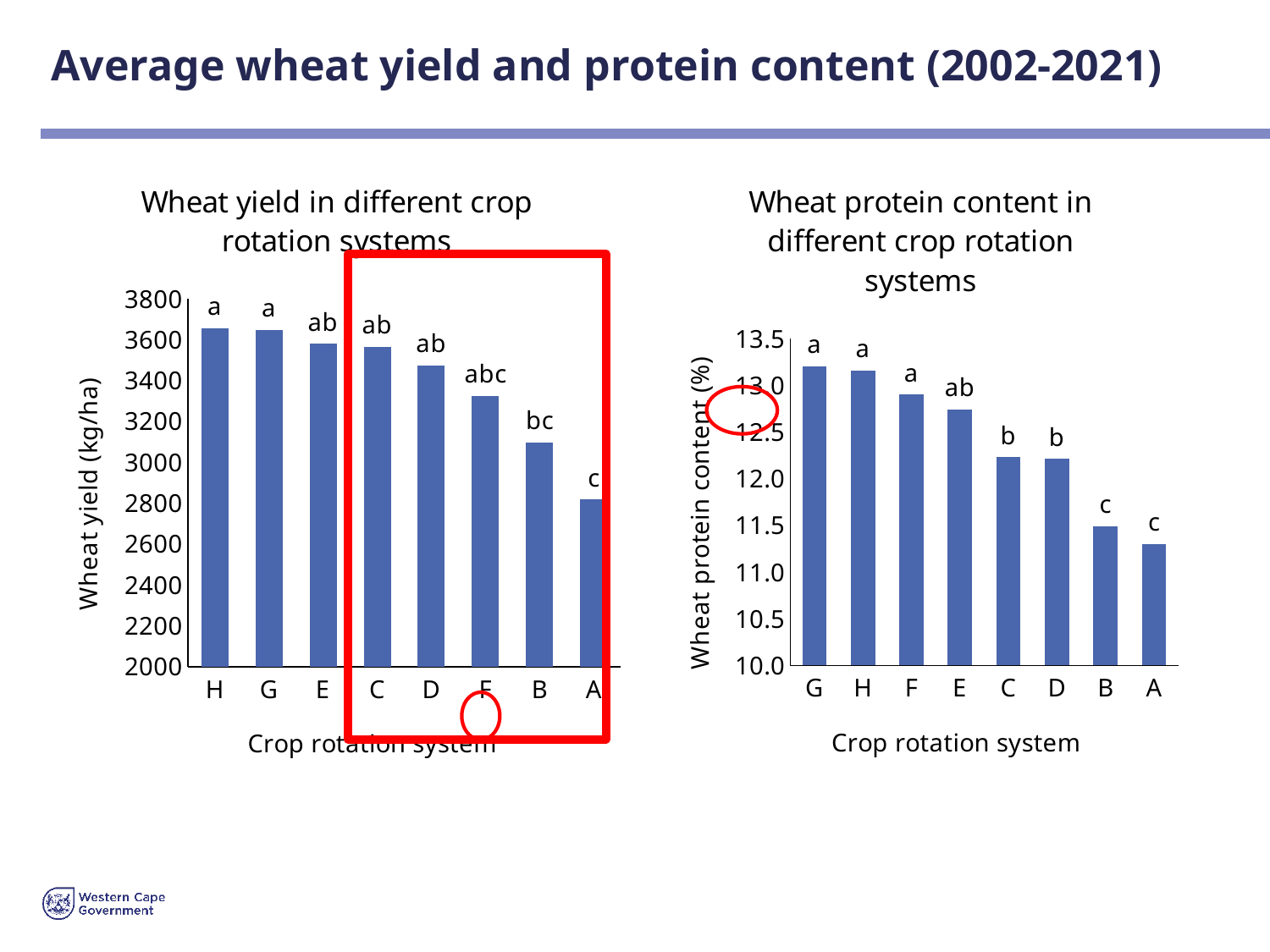
In the 'Wheat protein content in different crop rotation systems' chart, is the protein content for system A greater or less than 11.5? less In the 'Wheat yield in different crop rotation systems' chart, do the wheat yields rise or fall from left to right along the x axis? fall In the 'Wheat yield in different crop rotation systems' chart, is the wheat yield for system F greater or less than 3200? greater In the 'Wheat yield in different crop rotation systems' chart, is the wheat yield for system A greater or less than 3000? less In the 'Wheat yield in different crop rotation systems' chart, which crop rotation system has the lowest wheat yield? A How many crop rotation systems are shown in the 'Wheat yield in different crop rotation systems' chart? 8 What type of chart is the 'Wheat yield in different crop rotation systems' chart? bar chart In the 'Wheat protein content in different crop rotation systems' chart, which has a higher protein content, system G or system B? G What is the y-axis label of the 'Wheat protein content in different crop rotation systems' chart? Wheat protein content (%) How many crop rotation systems are shown in the 'Wheat protein content in different crop rotation systems' chart? 8 In the 'Wheat yield in different crop rotation systems' chart, which has a higher wheat yield, system H or system A? H